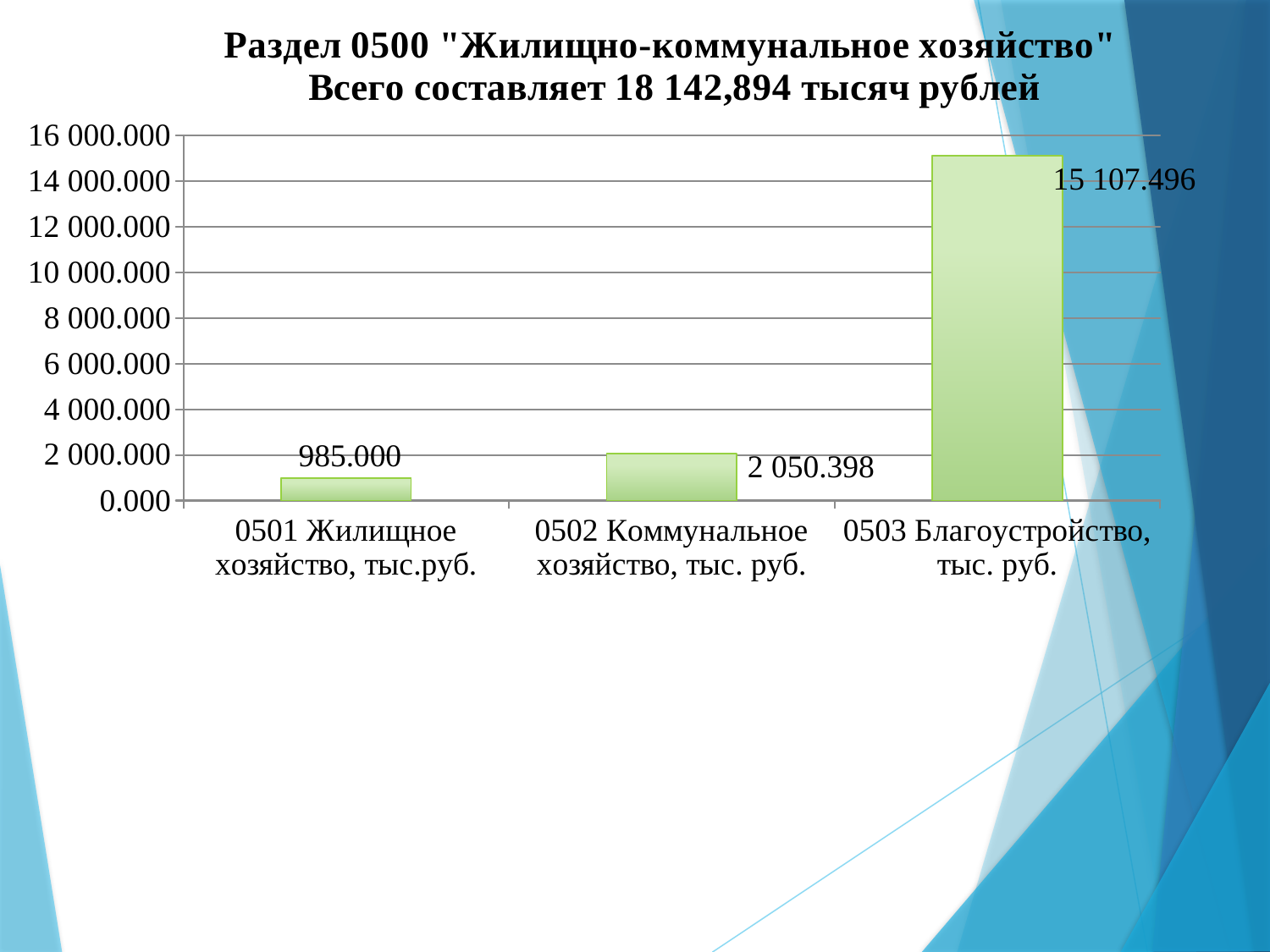
What is the value for 0503 Благоустройство? 15 107.496 What is the value for 0501 Жилищное хозяйство? 985.000 Is the value for 0503 Благоустройство greater or less than 14 000.000? greater What is the value for 0502 Коммунальное хозяйство? 2 050.398 What kind of chart is shown on the slide? bar chart What is the difference between the values for 0503 Благоустройство and 0502 Коммунальное хозяйство? 13 057.098 Which category has the highest value? 0503 Благоустройство According to the chart title, what is the total for Раздел 0500? 18 142,894 тысяч рублей How many categories are shown in the chart? 3 Which category has the lowest value? 0501 Жилищное хозяйство Which is larger, the value for 0502 Коммунальное хозяйство or 0501 Жилищное хозяйство? 0502 Коммунальное хозяйство What is the difference between the values for 0502 Коммунальное хозяйство and 0501 Жилищное хозяйство? 1 065.398